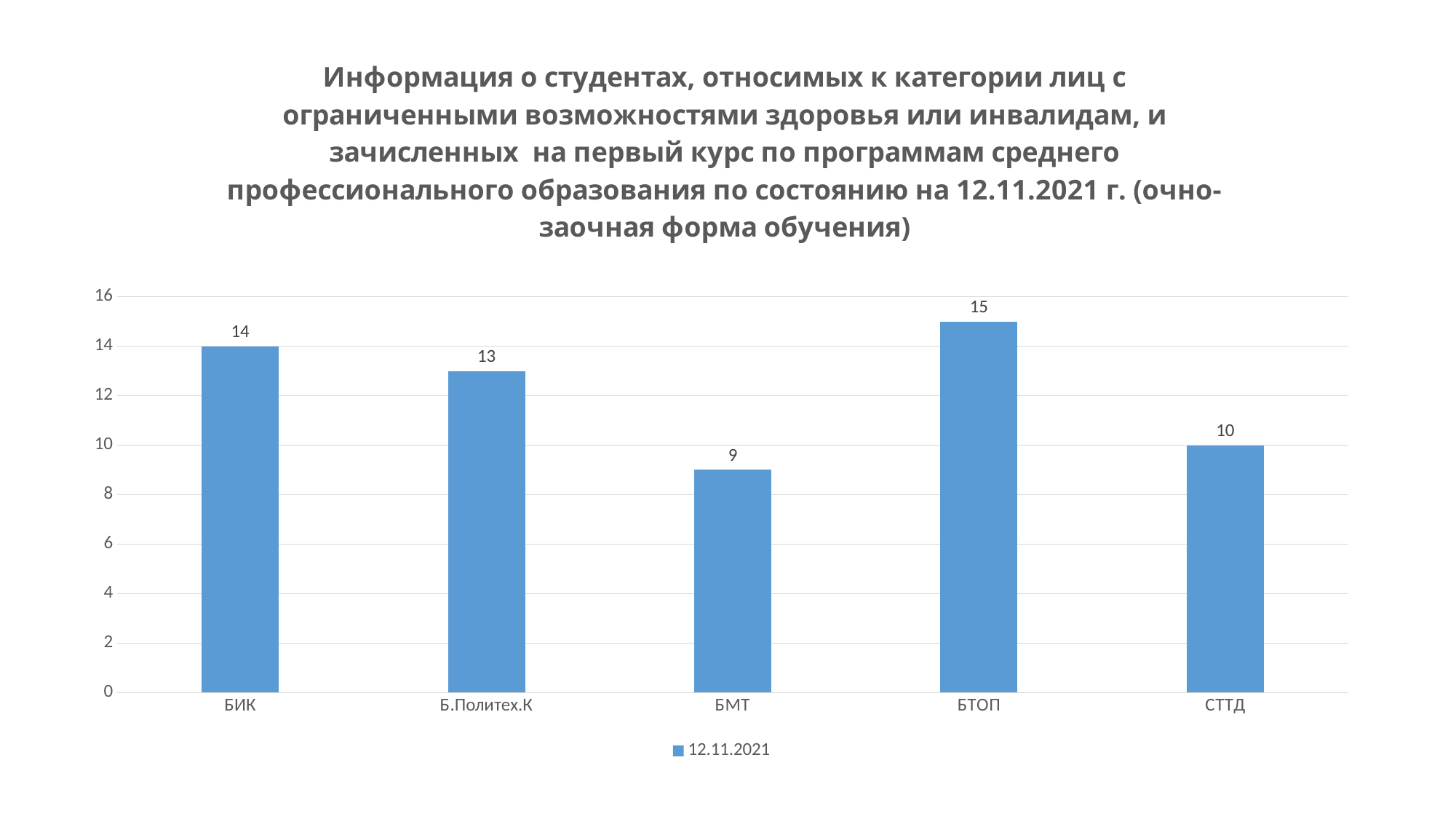
What is the value for СТТД? 10 How many categories are shown on the x axis? 5 How many series does the legend list? 1 What is the difference between the values for БИК and Б.Политех.К? 1 Is the value for БТОП greater or less than 12? greater What is the value for БМТ? 9 What is the value for БИК? 14 Which is larger, the value for Б.Политех.К or the value for СТТД? Б.Политех.К What kind of chart is shown on the slide? bar chart What is the difference between the values for БТОП and БМТ? 6 Which category has the highest value? БТОП Which category has the lowest value? БМТ